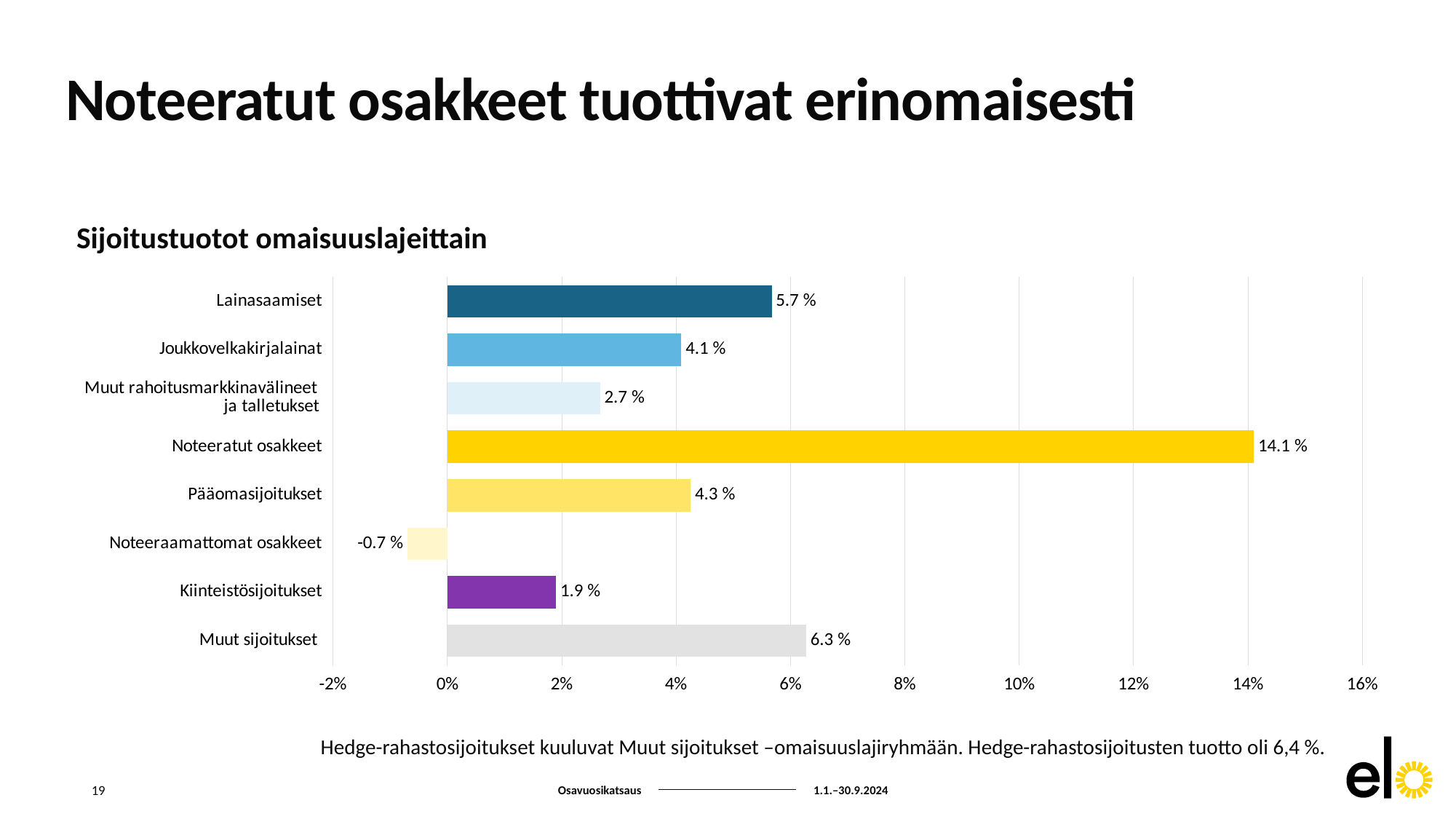
Is the value for Muut rahoitusmarkkinavälineet ja talletukset greater or less than 4%? less What is the value for Kiinteistösijoitukset? 1.9 % What is the title of the chart? Sijoitustuotot omaisuuslajeittain What is the value for Noteeraamattomat osakkeet? -0.7 % How many categories are shown in the chart? 8 Which category has the highest value? Noteeratut osakkeet What is the value for Noteeratut osakkeet? 14.1 % What kind of chart is shown on the slide? bar chart What is the value for Lainasaamiset? 5.7 % Which is larger, the value for Pääomasijoitukset or the value for Joukkovelkakirjalainat? Pääomasijoitukset Which category has the lowest value? Noteeraamattomat osakkeet What is the difference between the values for Muut sijoitukset and Joukkovelkakirjalainat? 2.2 %